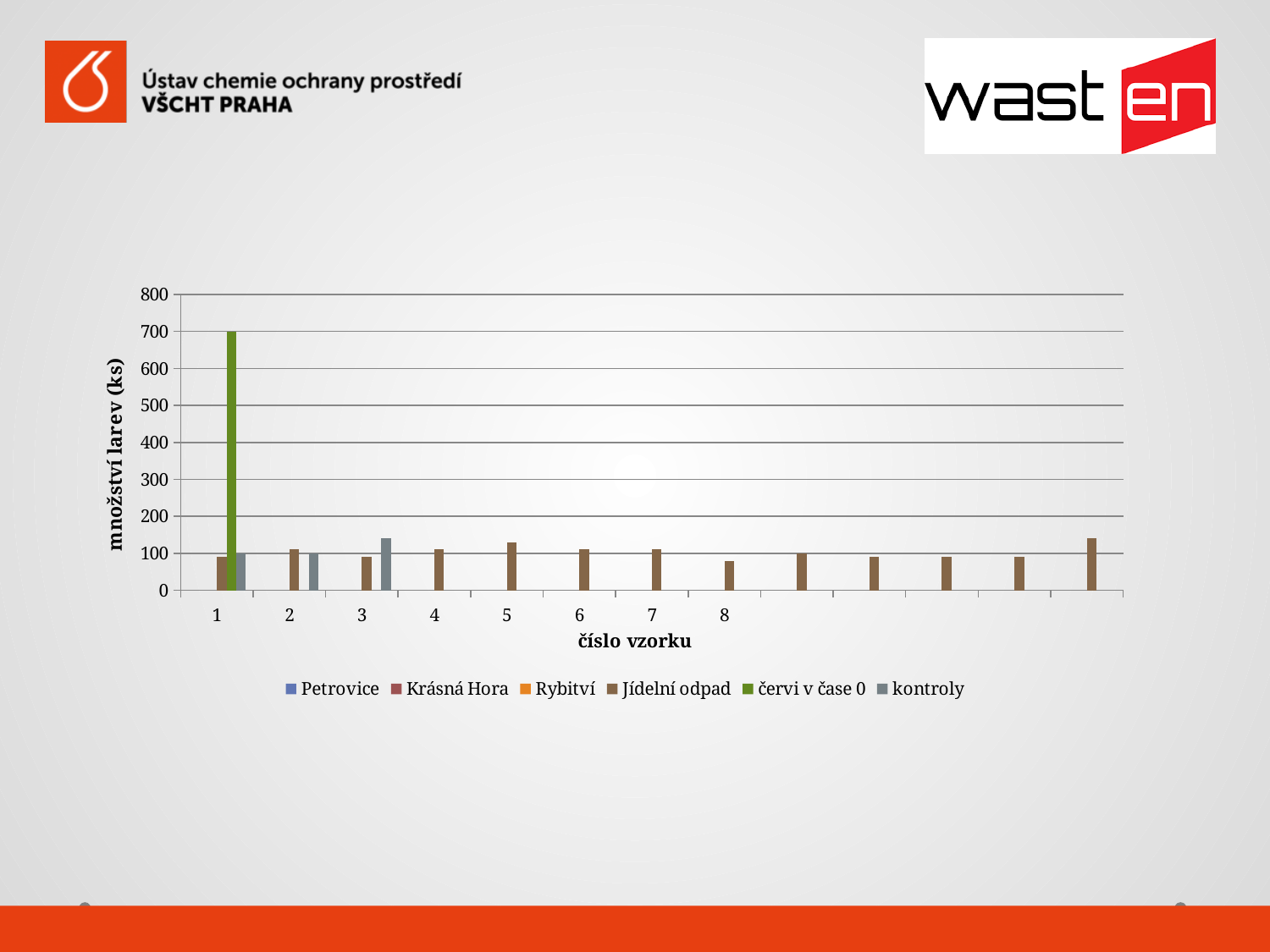
Is the value for 'Jídelní odpad' at sample 5 greater or less than 100? greater How many series does the legend list? 6 What is the title of the y axis? množství larev (ks) Which is larger: the 'Jídelní odpad' value at sample 5 or at sample 8? sample 5 Is the value for 'kontroly' at sample 3 greater or less than 100? greater Is the value for 'Jídelní odpad' at sample 8 greater or less than 100? less Which series has the tallest bar in the chart? červi v čase 0 At sample 3, which is larger: the 'kontroly' bar or the 'Jídelní odpad' bar? kontroly What is the value of the 'červi v čase 0' bar at sample 1? 700 What is the title of the x axis? číslo vzorku What kind of chart is shown on the slide? bar chart